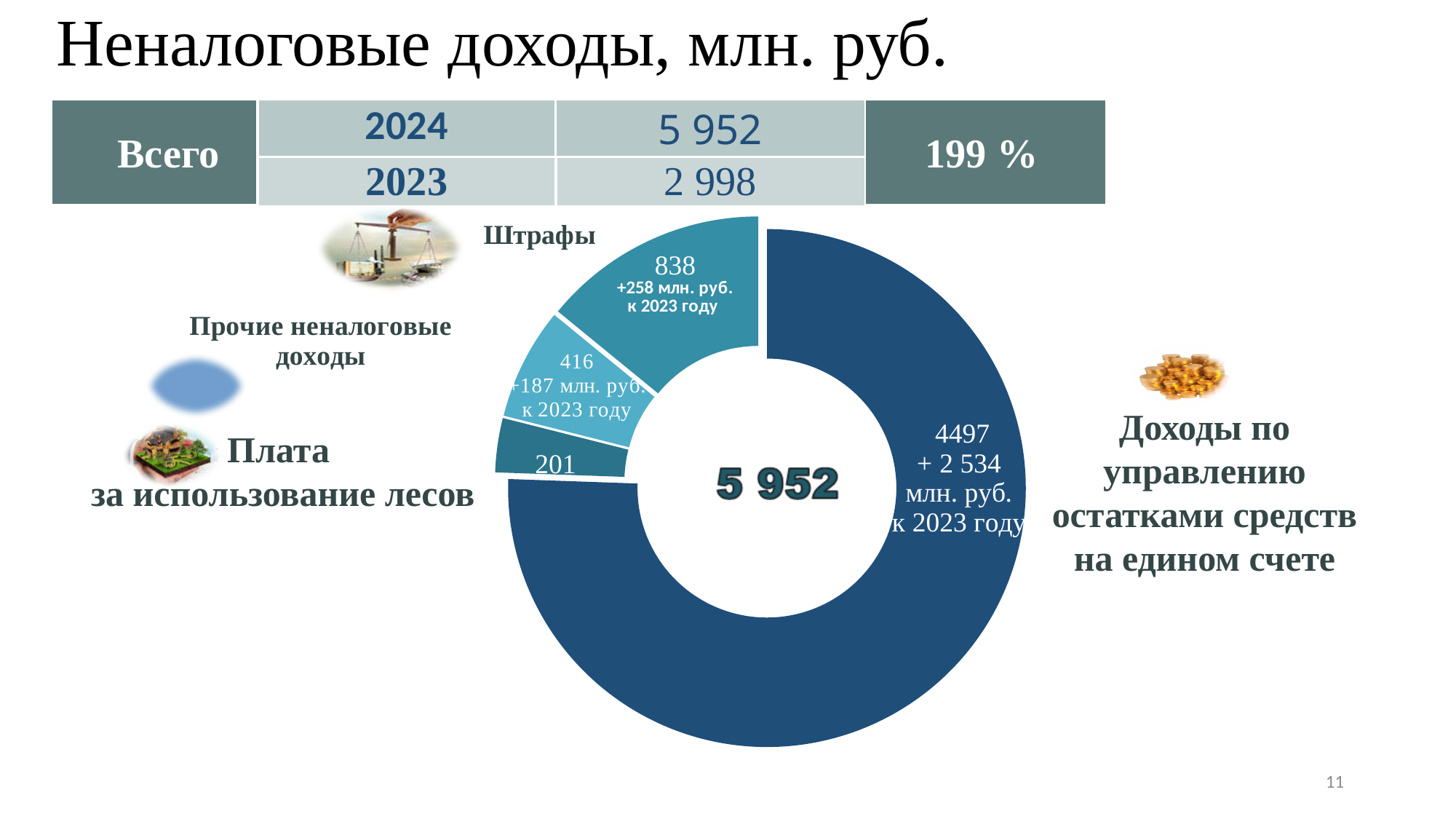
What total is shown in the centre of the donut chart? 5 952 By how much did Штрафы increase compared to 2023, according to the chart label? +258 млн. руб. What is the value for Доходы по управлению остатками средств на едином счете in the donut chart? 4497 What type of chart is shown on the slide? Donut (pie) chart Which category has the smallest segment in the donut chart? Плата за использование лесов What is the value for Штрафы in the donut chart? 838 How many segments does the donut chart have? 4 Which is larger: the value for Прочие неналоговые доходы or the value for Плата за использование лесов? Прочие неналоговые доходы What is the value for Прочие неналоговые доходы in the donut chart? 416 Which category has the largest segment in the donut chart? Доходы по управлению остатками средств на едином счете What is the difference between the values for Штрафы and Прочие неналоговые доходы? 422 What is the value for Плата за использование лесов in the donut chart? 201